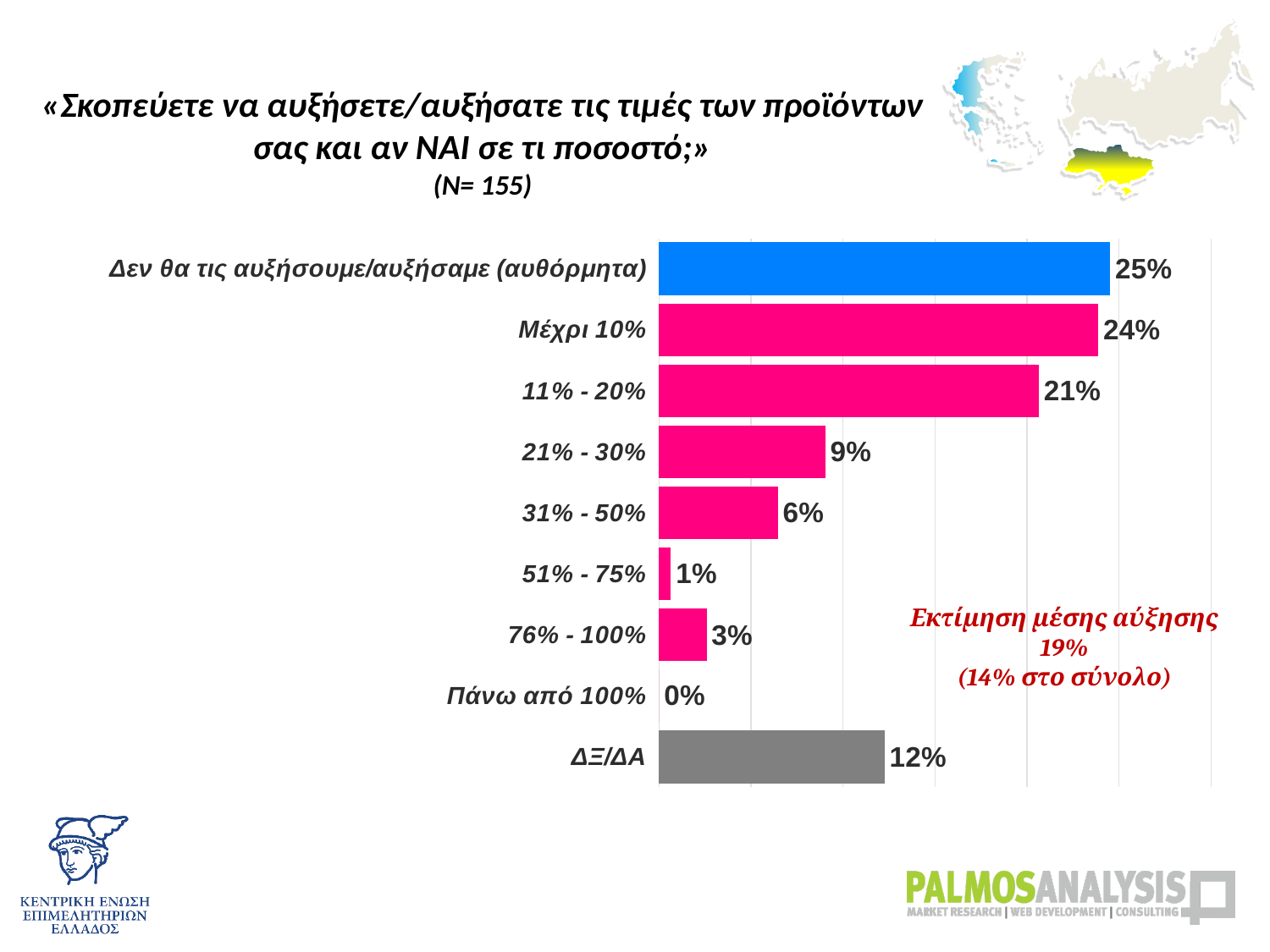
How many categories are shown in the chart? 9 What is the value for the category "21% - 30%"? 9% Which category has the lowest value? Πάνω από 100% What is the difference between the values for "11% - 20%" and "31% - 50%"? 15% What is the value for the category "Πάνω από 100%"? 0% Which is larger, the value for "76% - 100%" or the value for "51% - 75%"? 76% - 100% What is the value for the category "ΔΞ/ΔΑ"? 12% What is the value for the category "Μέχρι 10%"? 24% What is the estimated average increase (Εκτίμηση μέσης αύξησης) noted on the chart? 19% Which category has the highest value? Δεν θα τις αυξήσουμε/αυξήσαμε (αυθόρμητα) What kind of chart is shown on the slide? Bar chart What is the sample size (N) stated in the chart title? 155